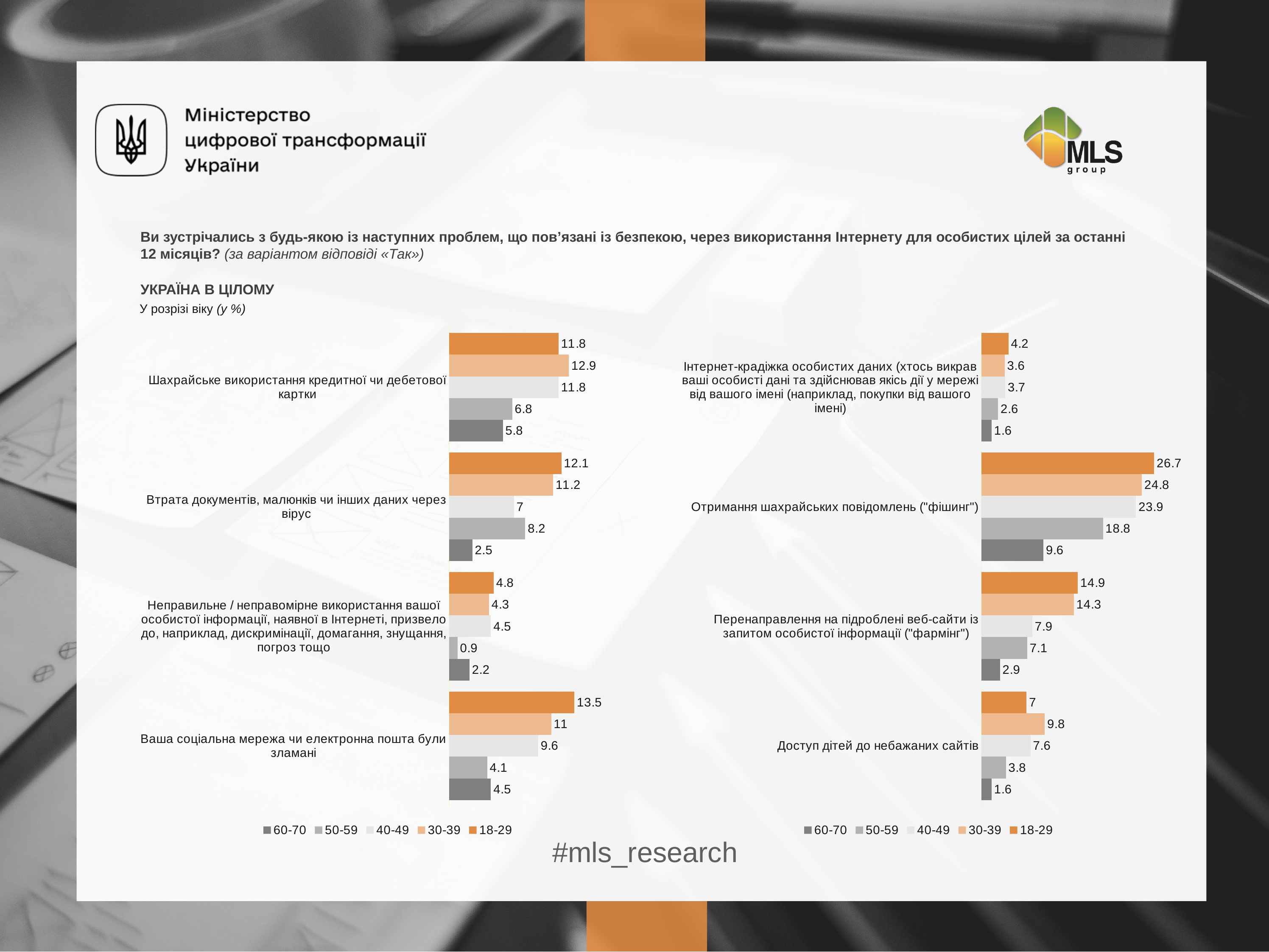
In the left chart, what is the value for the 18-29 age group for "Ваша соціальна мережа чи електронна пошта були зламані"? 13.5 In the right chart, which age group has the highest value for "Доступ дітей до небажаних сайтів"? 30-39 How many categories (problem types) are shown in the left chart? 4 In the right chart, what is the difference between the 18-29 and 60-70 values for "Отримання шахрайських повідомлень ("фішинг")"? 17.1 In the left chart, which age group has the lowest value for "Неправильне / неправомірне використання вашої особистої інформації"? 50-59 In the right chart, what is the total of the five age-group values for "Інтернет-крадіжка особистих даних"? 15.7 How many series does the legend of the right chart list? 5 In the right chart, which is larger for "Перенаправлення на підроблені веб-сайти": the 40-49 value or the 60-70 value? 40-49 In the left chart, what is the value for the 50-59 age group for "Втрата документів, малюнків чи інших даних через вірус"? 8.2 In the right chart, what is the value for the 60-70 age group for "Отримання шахрайських повідомлень ("фішинг")"? 9.6 What type of chart is the right chart? Bar chart In the left chart, which is larger for "Шахрайське використання кредитної чи дебетової картки": the 30-39 value or the 50-59 value? 30-39